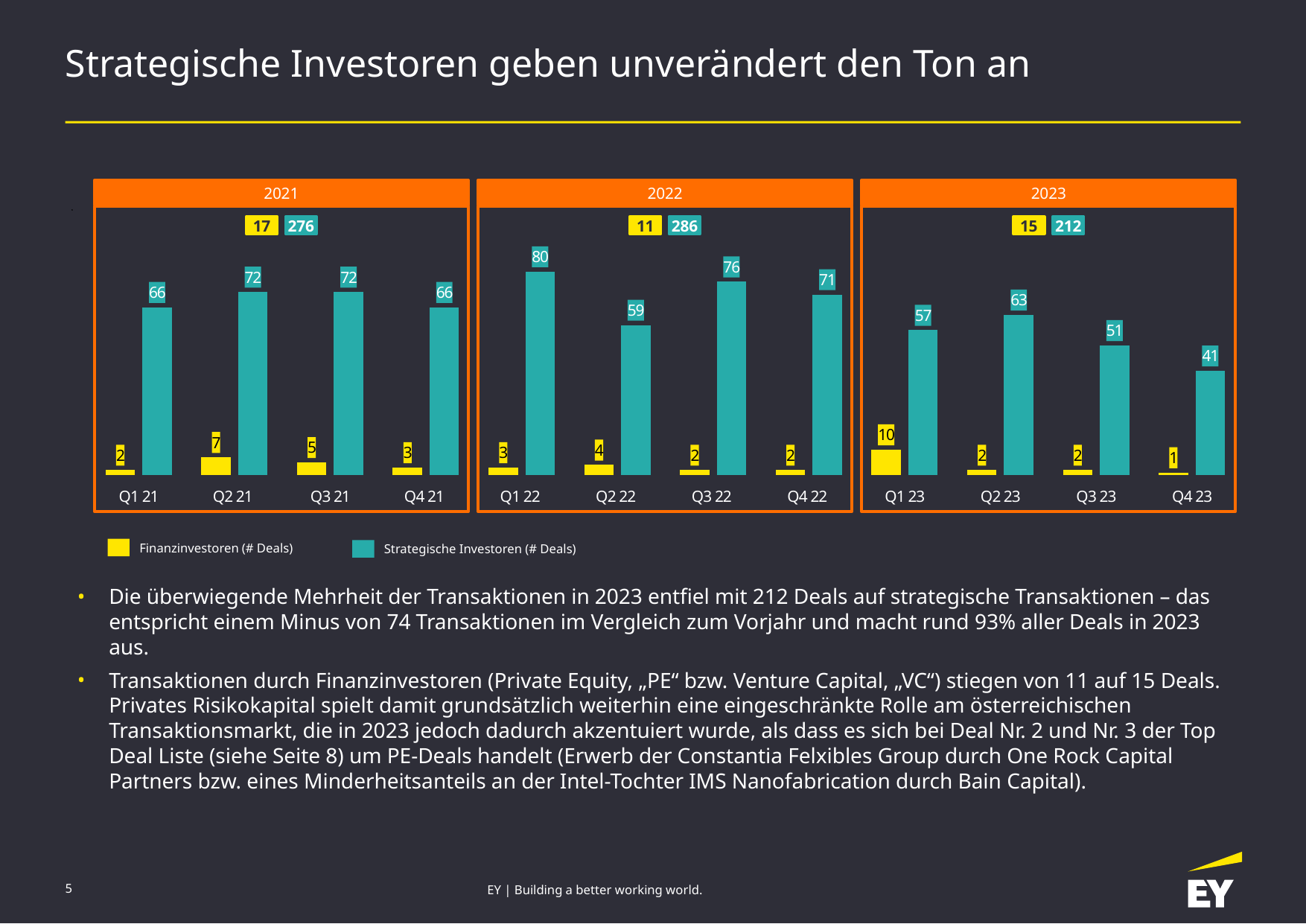
In the 2023 panel, do the Strategische Investoren values rise or fall from Q2 23 to Q4 23? Fall How many quarters are shown in the 2021 panel? 4 In the 2023 panel, what is the value for Finanzinvestoren in Q1 23? 10 How many series does the legend list? 2 In the 2022 panel, which quarter has the highest value for Strategische Investoren? Q1 22 What kind of chart is shown in each panel? Bar chart In the 2022 panel, which is larger: the Strategische Investoren value for Q3 22 or for Q2 22? Q3 22 What is the annual total for Strategische Investoren shown in the 2022 panel? 286 In the 2023 panel, what is the difference between the Strategische Investoren values for Q2 23 and Q4 23? 22 In the 2023 panel, which quarter has the lowest value for Strategische Investoren? Q4 23 In the 2022 panel, what is the value for Strategische Investoren in Q1 22? 80 In the 2021 panel, what is the value for Strategische Investoren in Q4 21? 66